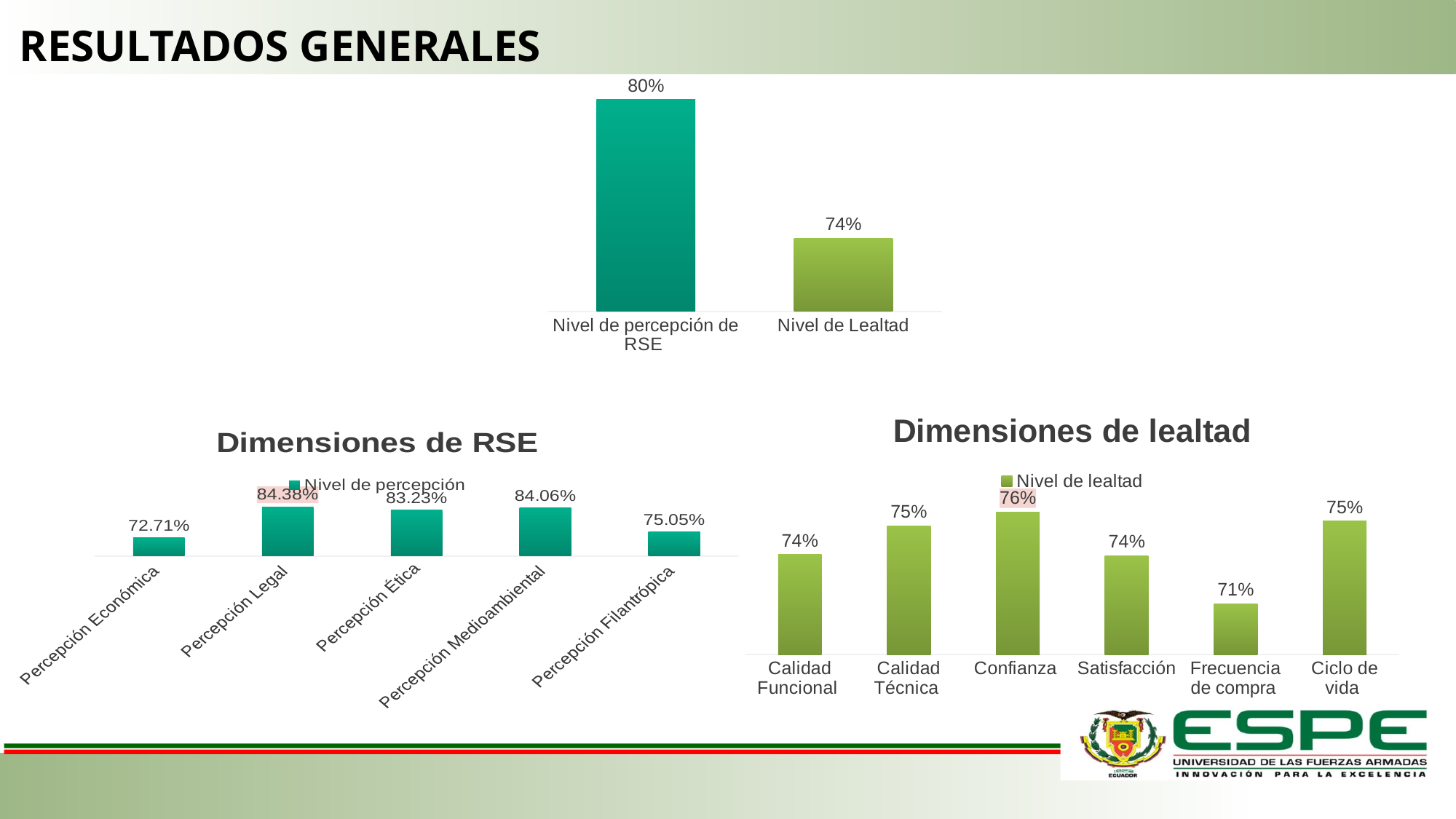
In the Dimensiones de RSE chart, which category has the highest value? Percepción Legal In the Dimensiones de lealtad chart, how many categories are plotted? 6 In the Dimensiones de lealtad chart, which category has the highest value? Confianza In the top chart, what is the value for Nivel de Lealtad? 74% In the Dimensiones de lealtad chart, what is the name of the series shown in the legend? Nivel de lealtad In the top chart, what is the difference between Nivel de percepción de RSE and Nivel de Lealtad? 6% In the Dimensiones de RSE chart, which category has the lowest value? Percepción Económica In the Dimensiones de RSE chart, what is the value for Percepción Filantrópica? 75.05% In the Dimensiones de RSE chart, what is the value for Percepción Económica? 72.71% In the Dimensiones de RSE chart, how many categories are plotted? 5 In the Dimensiones de lealtad chart, which category has the lowest value? Frecuencia de compra In the top chart, what is the value for Nivel de percepción de RSE? 80%